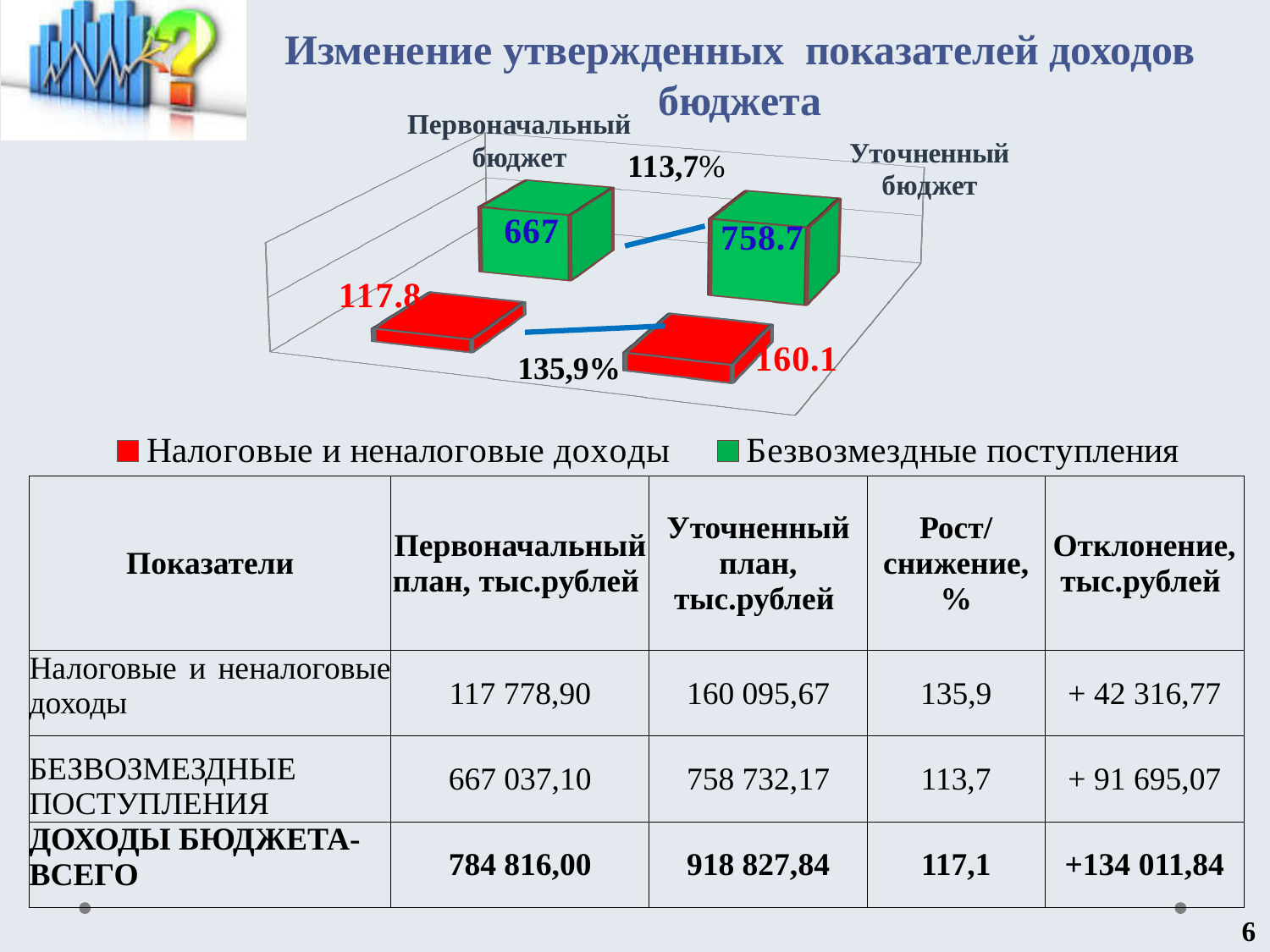
Which category has the lower value for Налоговые и неналоговые доходы? Первоначальный бюджет What is the value of Налоговые и неналоговые доходы for Уточненный бюджет? 160.1 Which is larger: Безвозмездные поступления for Первоначальный бюджет or Налоговые и неналоговые доходы for Уточненный бюджет? Безвозмездные поступления for Первоначальный бюджет What is the value of Безвозмездные поступления for Уточненный бюджет? 758.7 What is the value of Налоговые и неналоговые доходы for Первоначальный бюджет? 117.8 What is the difference between the Уточненный бюджет and Первоначальный бюджет values for Налоговые и неналоговые доходы? 42.3 Which colour represents Безвозмездные поступления in the chart? Green Which category has the higher value for Безвозмездные поступления? Уточненный бюджет What kind of chart is shown on the slide? Bar chart How many categories are shown on the chart? 2 What is the value of Безвозмездные поступления for Первоначальный бюджет? 667 How many series does the chart legend list? 2